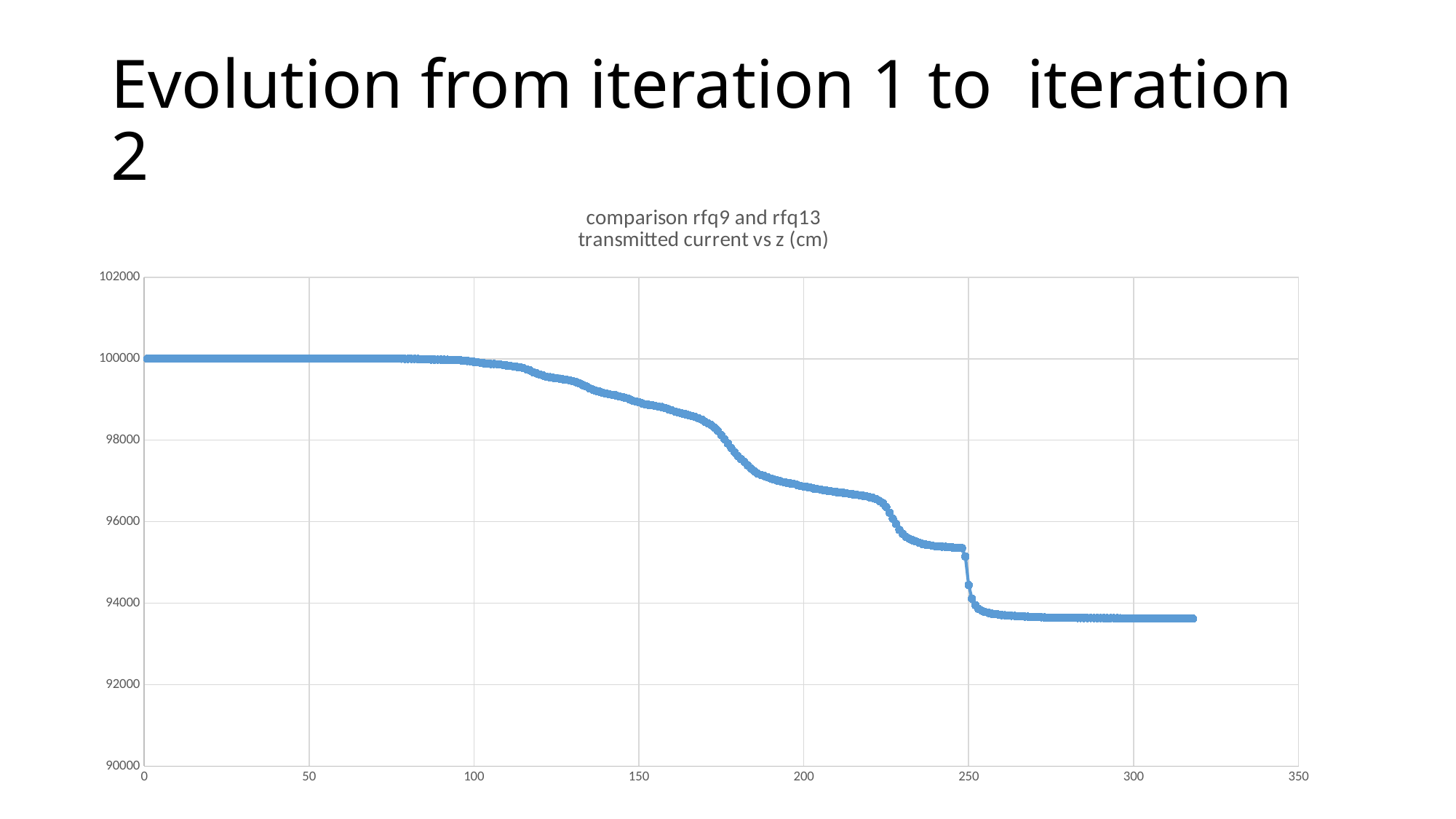
Is the value at z = 150 greater or less than 98000? greater What is the highest value shown on the y axis? 102000 Do the plotted values rise or fall as z increases along the x axis? fall Is the value at z = 225 greater or less than 98000? less Is the value at z = 200 greater or less than 96000? greater What is the title of the chart? comparison rfq9 and rfq13 transmitted current vs z (cm) What kind of chart is shown on the slide? scatter chart